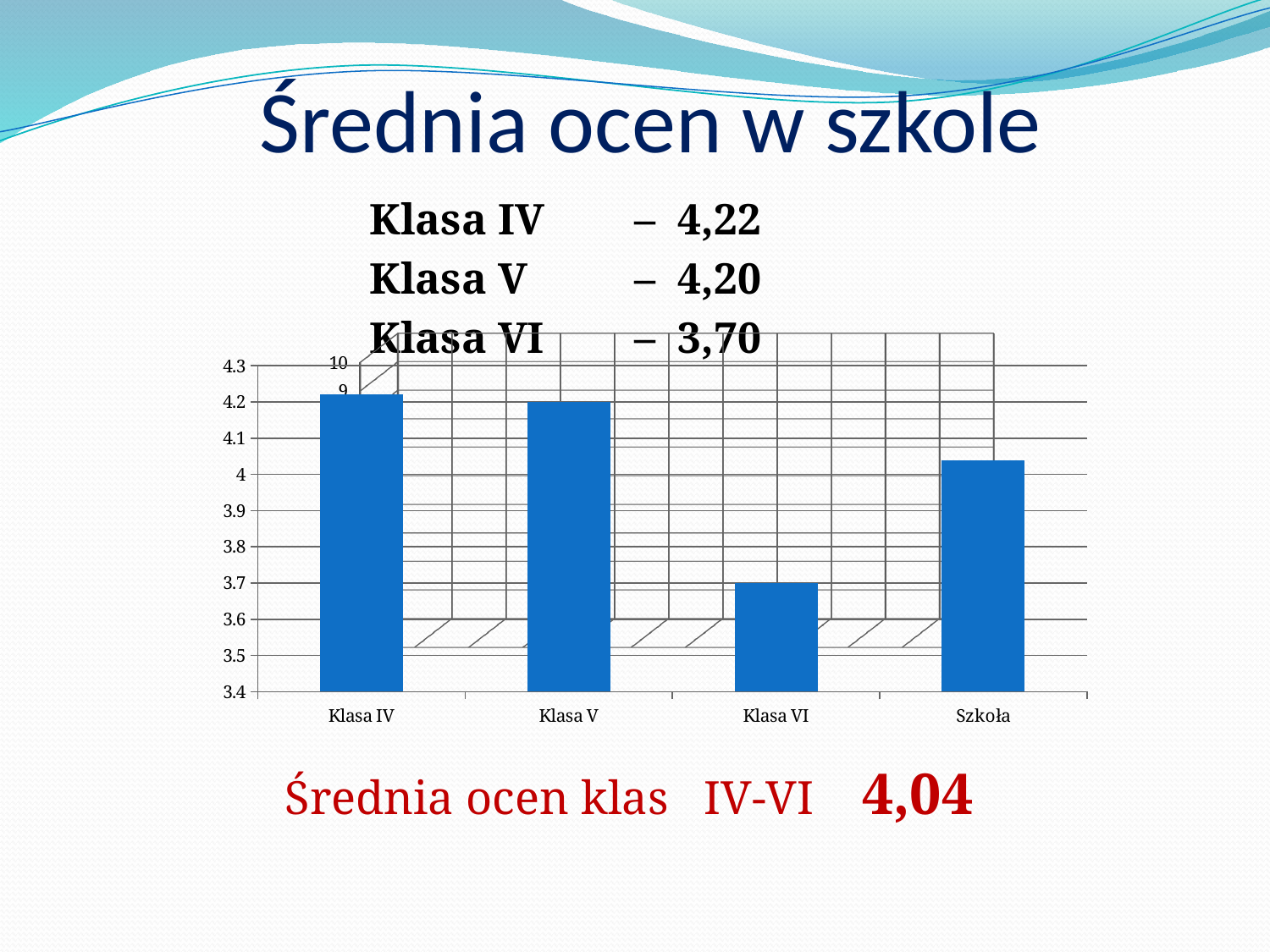
Which is larger, the average for Klasa V or for Klasa VI? Klasa V What is the average grade for Klasa VI? 3,70 Which class has the lowest average grade in the chart? Klasa VI Is the value for Szkoła greater or less than 4? greater What type of chart is shown on the slide? bar chart What is the average grade for Klasa IV shown on the slide? 4,22 What is the value of the Szkoła bar (the average for classes IV-VI)? 4,04 What is the difference between the average grades of Klasa V and Klasa VI? 0,50 Which category has the highest bar in the chart? Klasa IV What is the difference between the average grades of Klasa IV and Klasa VI? 0,52 How many bars are shown in the chart? 4 What is the average grade for Klasa V? 4,20